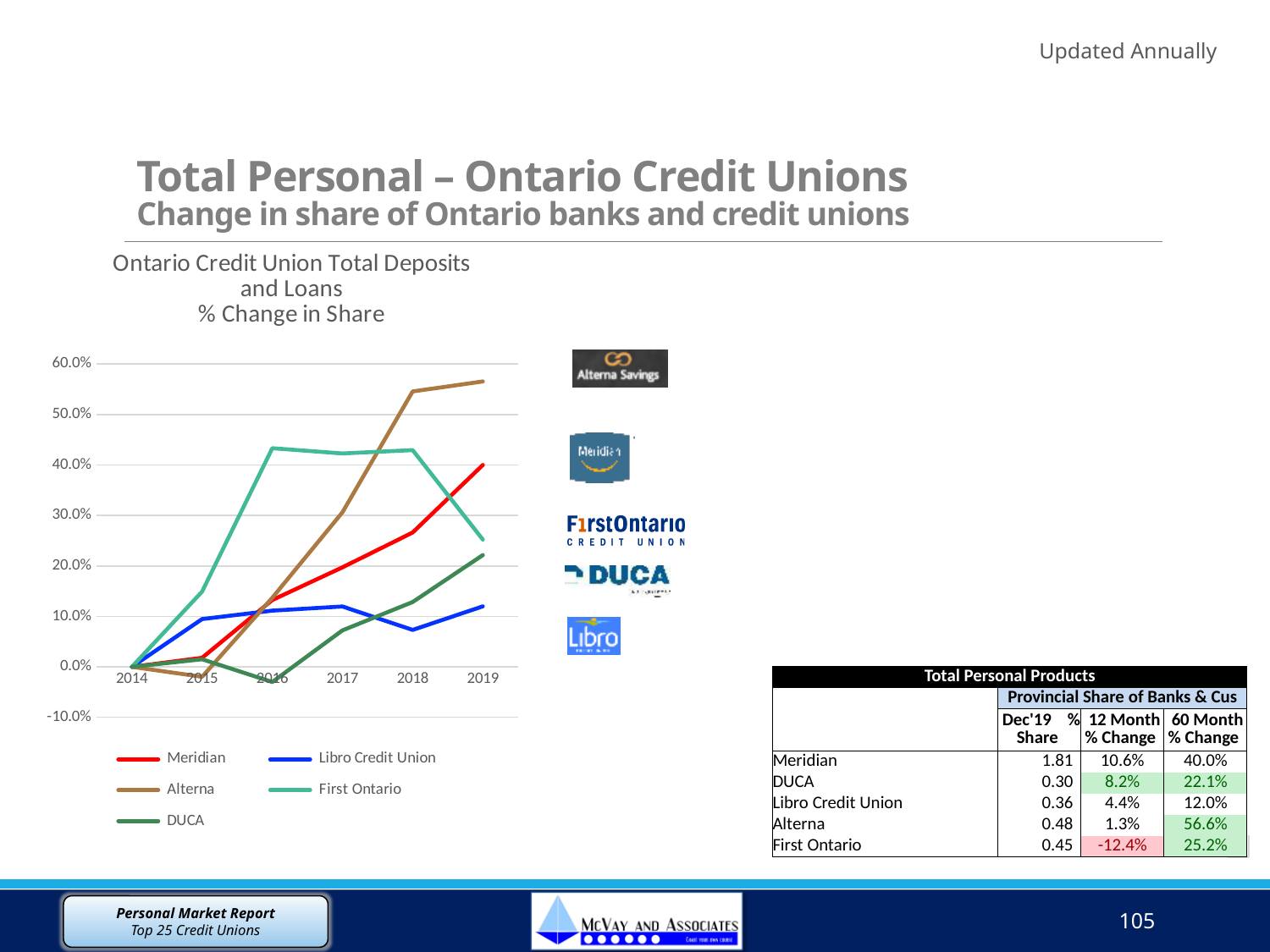
Which credit union has the highest % change in share in 2019? Alterna How many years are shown along the x axis of the chart? 6 Is the value for First Ontario in 2016 greater or less than 40.0%? greater What kind of chart is shown on the slide? line chart In 2018, which is larger: the value for Alterna or the value for Meridian? Alterna Is the value for Alterna in 2019 greater or less than 50.0%? greater Which credit union has the lowest % change in share in 2019? Libro Credit Union Does the Alterna line rise or fall from 2016 to 2019? rise Which credit union has the highest % change in share in 2016? First Ontario How many series does the chart's legend list? 5 What colour is the Meridian line in the chart? red